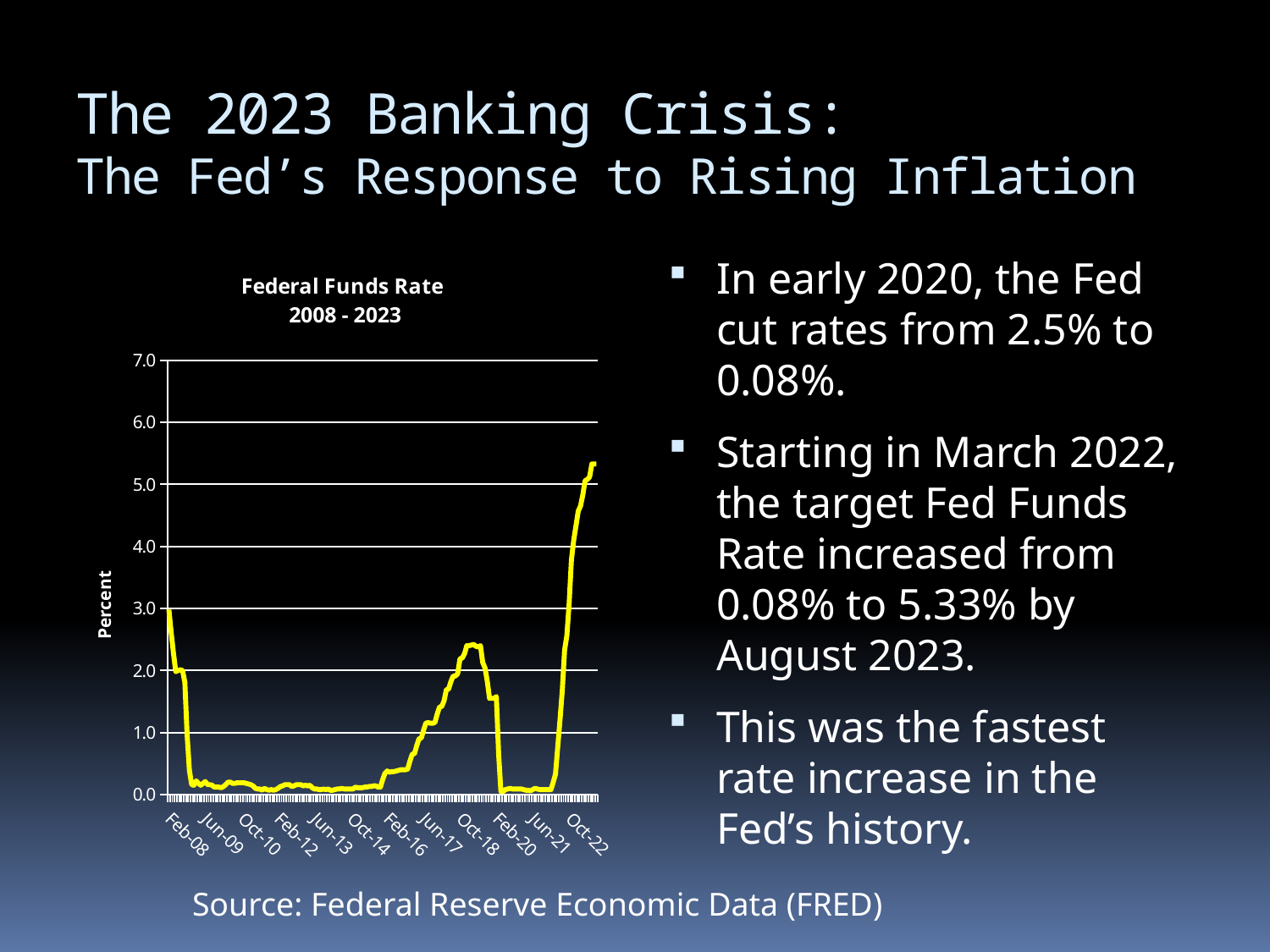
Is the value at Jun-21 greater or less than 1.0? less Is the value at Feb-08 greater or less than 2.0? greater What kind of chart is shown on the slide? line chart What is the title of the chart? Federal Funds Rate 2008 - 2023 Is the highest value reached at the right end of the chart greater or less than 5.0? greater How many date labels are shown on the x axis? 12 Does the Federal Funds Rate rise or fall between Jun-21 and the end of the series? rise What is the label on the vertical axis of the chart? Percent Which is higher: the peak around Oct-18 or the peak at the right end of the chart? the peak at the right end